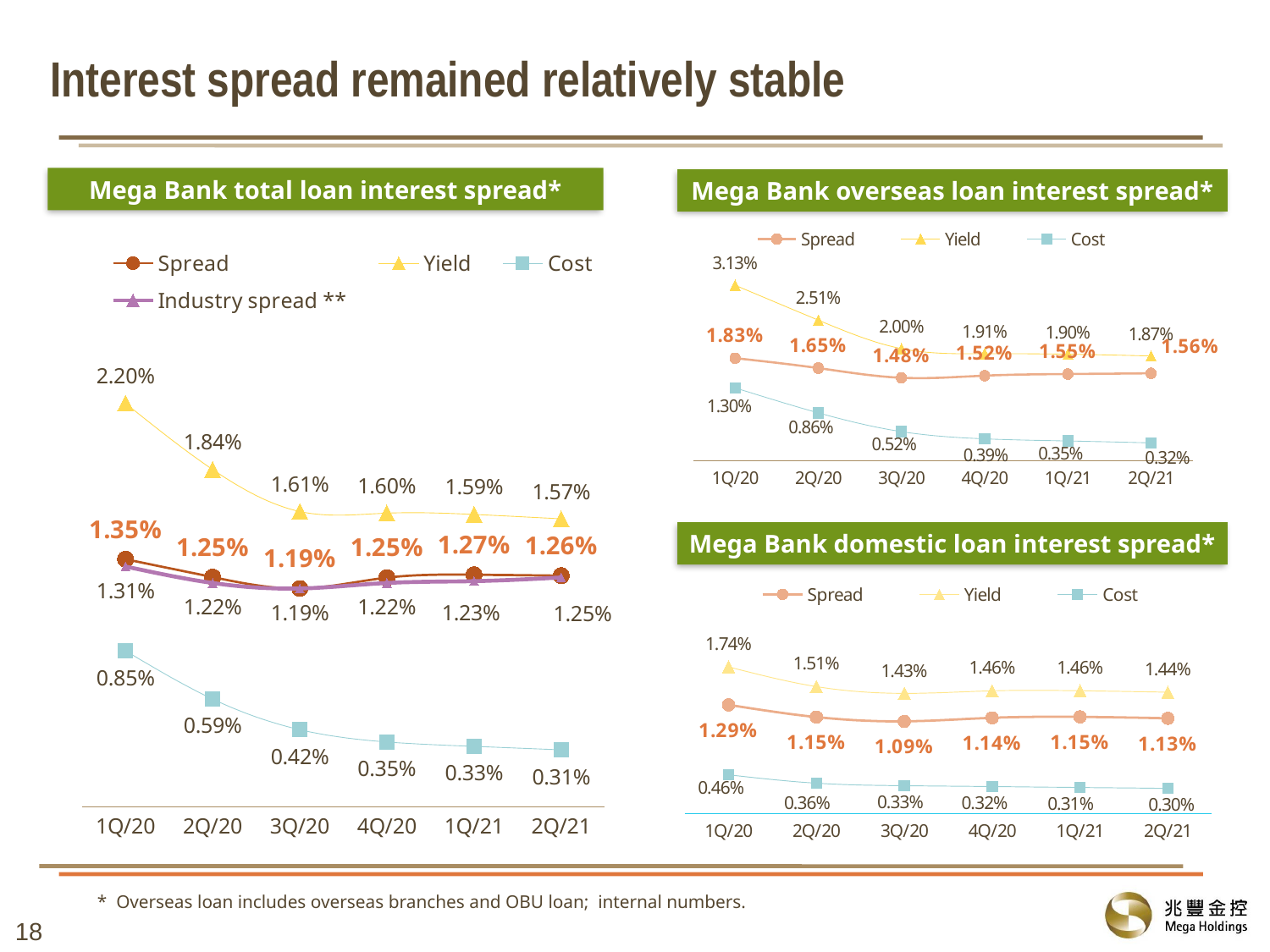
In the 'Mega Bank overseas loan interest spread*' chart, what is the Yield value for 1Q/20? 3.13% In the 'Mega Bank total loan interest spread*' chart, how many series does the legend list? 4 In the 'Mega Bank total loan interest spread*' chart, what is the Spread value for 1Q/20? 1.35% In the 'Mega Bank total loan interest spread*' chart, what is the Cost value for 3Q/20? 0.42% In the 'Mega Bank overseas loan interest spread*' chart, what is the Spread value for 2Q/21? 1.56% In the 'Mega Bank domestic loan interest spread*' chart, which is larger, the Yield in 1Q/20 or the Yield in 2Q/20? 1Q/20 In the 'Mega Bank overseas loan interest spread*' chart, does the Cost rise or fall from 1Q/20 to 2Q/21? fall In the 'Mega Bank total loan interest spread*' chart, what is the Yield value for 2Q/21? 1.57% In the 'Mega Bank total loan interest spread*' chart, in which quarter is the Spread lowest? 3Q/20 In the 'Mega Bank domestic loan interest spread*' chart, what is the Spread value for 3Q/20? 1.09% What kind of chart is the 'Mega Bank domestic loan interest spread*' chart? line chart In the 'Mega Bank total loan interest spread*' chart, what is the difference between the Yield and the Cost in 1Q/20? 1.35%